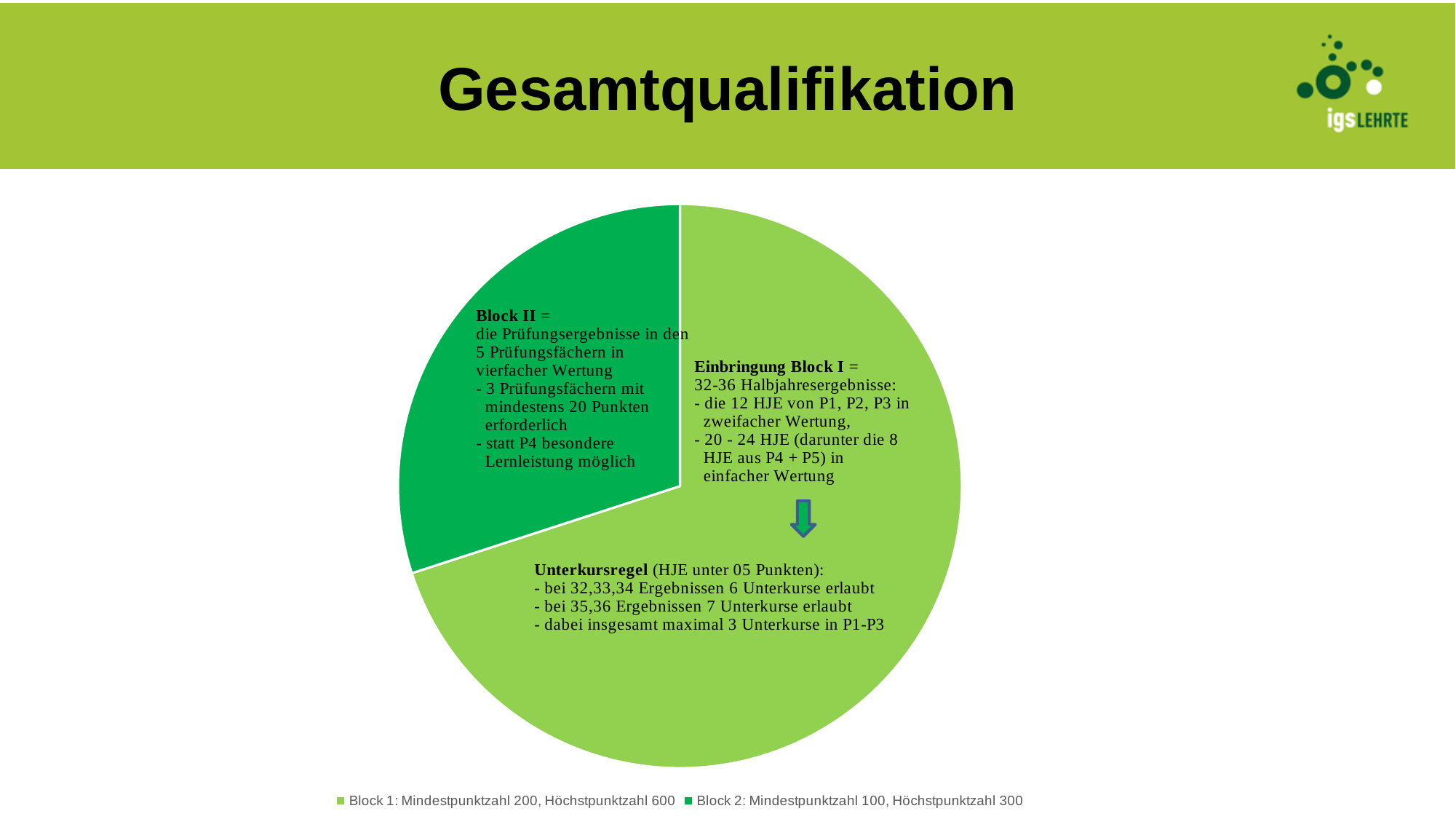
Which slice of the pie chart is the smallest? Block 2: Mindestpunktzahl 100, Höchstpunktzahl 300 What is the title of the slide containing the pie chart? Gesamtqualifikation How many entries does the legend of the pie chart list? 2 What kind of chart is shown on the slide? pie chart Does the Block 1 slice take up more or less than half of the pie chart? more Which slice of the pie chart is the largest? Block 1: Mindestpunktzahl 200, Höchstpunktzahl 600 How many slices does the pie chart have? 2 What colour is the Block 2 slice in the pie chart? dark green Which slice is larger in the pie chart, Block 1 or Block 2? Block 1